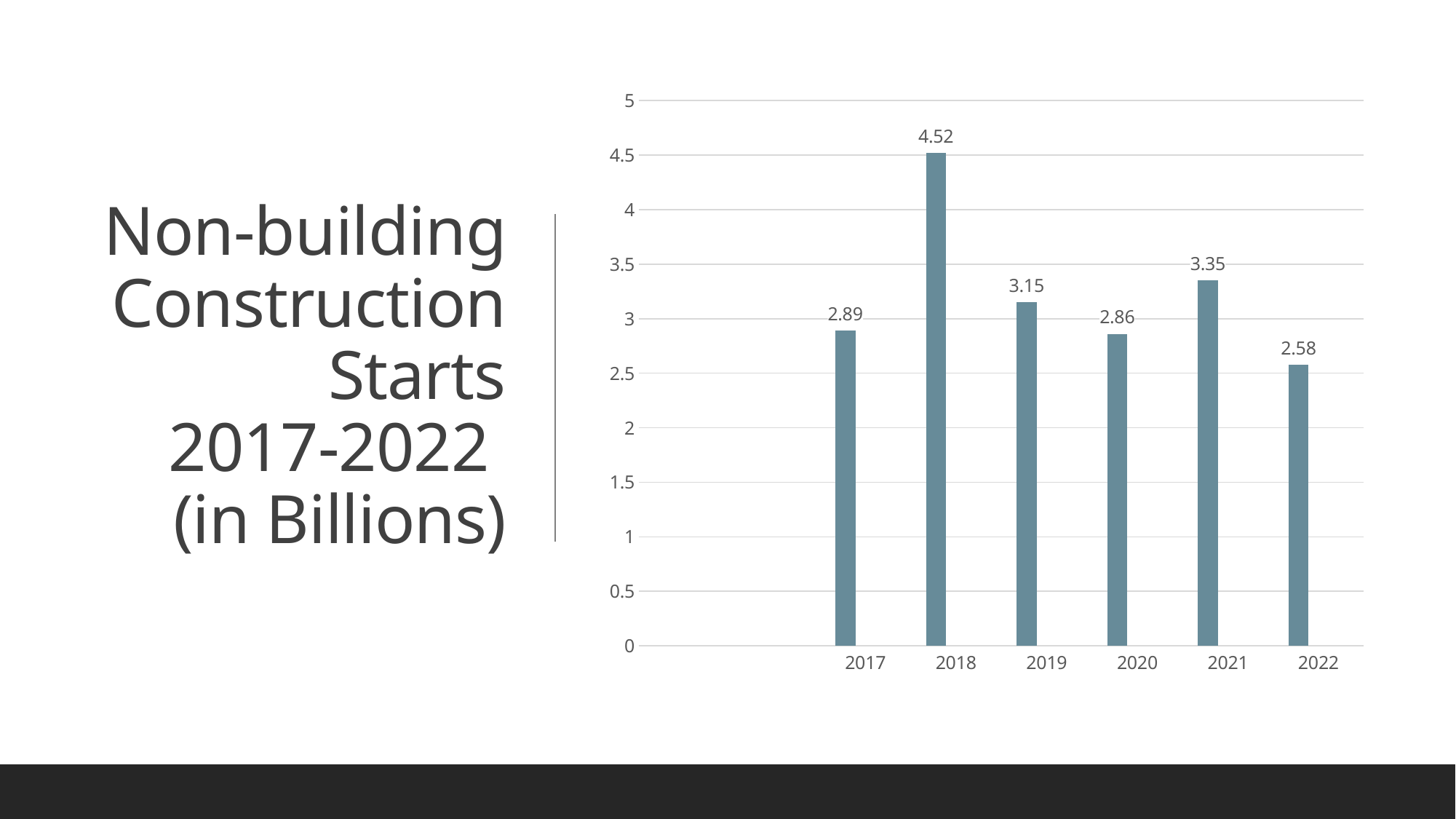
Which year has the highest value? 2018 What is the value for 2020? 2.86 What is the value for 2022? 2.58 Which year has the lowest value? 2022 What is the title of the slide? Non-building Construction Starts 2017-2022 (in Billions) What is the difference between the values for 2021 and 2022? 0.77 Which is larger, the value for 2017 or the value for 2021? 2021 What kind of chart is shown on the slide? bar chart How many years are shown on the x axis? 6 What is the difference between the values for 2018 and 2019? 1.37 Is the value for 2019 greater or less than 3? greater What is the value for 2018? 4.52